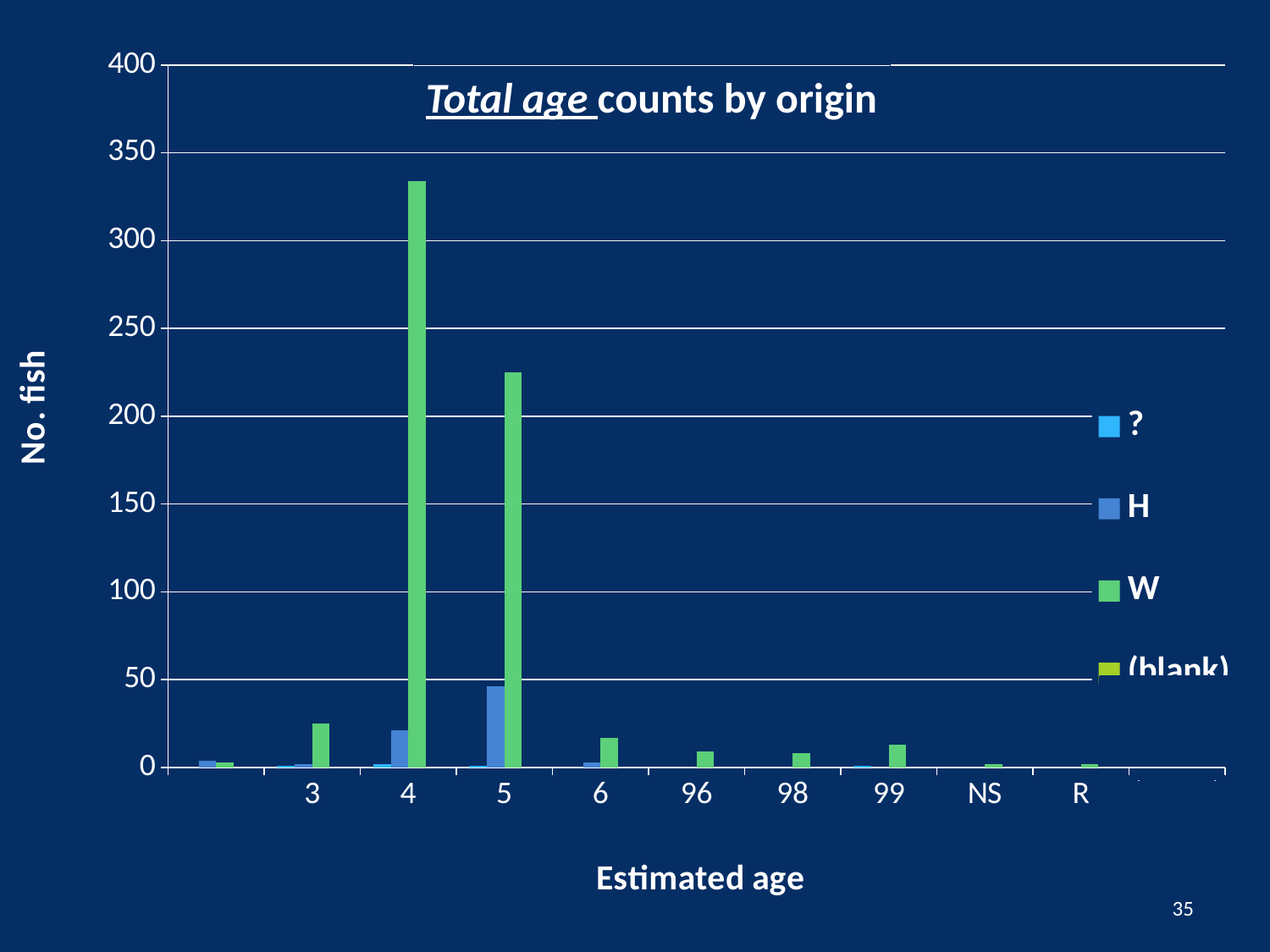
Is the value for H at estimated age 5 greater or less than 50? less What is the label of the vertical axis? No. fish Which is larger for the W series: the value at estimated age 4 or at estimated age 5? 4 How many series does the legend list? 4 What kind of chart is shown on the slide? bar chart For which estimated age is the W series highest? 4 Is the value for W at estimated age 3 greater or less than 50? less Is the value for W at estimated age 4 greater or less than 300? greater What is the title of the chart? Total age counts by origin Which is larger for the H series: the value at estimated age 4 or at estimated age 5? 5